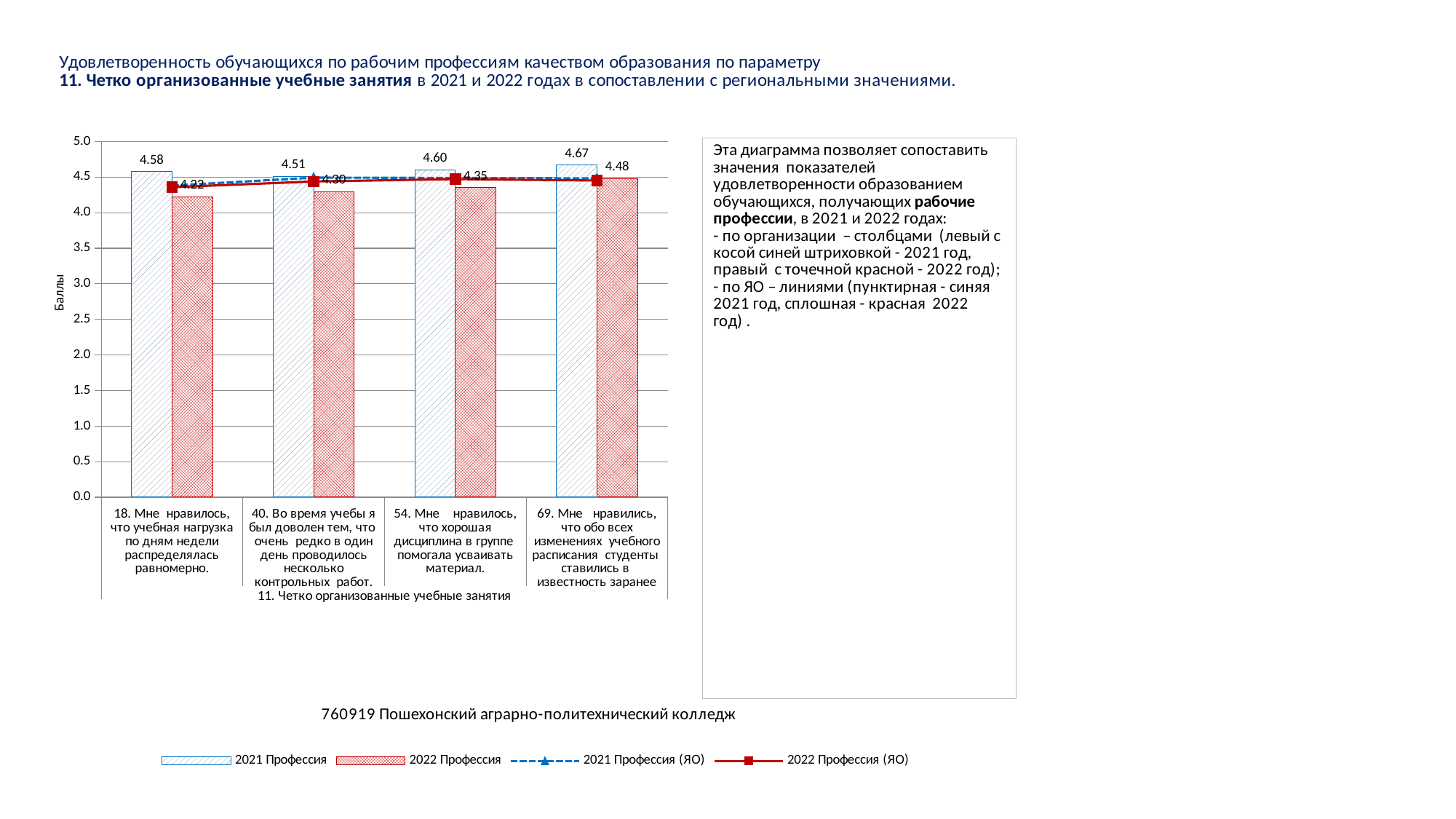
What is the value of the 2021 Профессия bar for item 69 (Мне нравились, что обо всех изменениях учебного расписания студенты ставились в известность заранее)? 4.67 Which item has the lowest 2021 Профессия bar? 40. Во время учебы я был доволен тем, что очень редко в один день проводилось несколько контрольных работ Which item has the highest 2021 Профессия bar? 69. Мне нравились, что обо всех изменениях учебного расписания студенты ставились в известность заранее What is the value of the 2022 Профессия bar for item 54 (Мне нравилось, что хорошая дисциплина в группе помогала усваивать материал)? 4.35 Which is larger: the 2021 Профессия value for item 54 or for item 18? Item 54 (4.60) Is the 2022 Профессия (ЯО) line value for item 18 greater or less than 4.0? greater What is the value of the 2021 Профессия bar for item 18 (Мне нравилось, что учебная нагрузка по дням недели распределялась равномерно)? 4.58 What is the value of the 2022 Профессия bar for item 69? 4.48 How many categories (survey items) are shown on the x axis? 4 What is the difference between the 2021 Профессия and 2022 Профессия values for item 69? 0.19 Do the 2022 Профессия bar values rise or fall from left to right along the x axis? rise How many series does the legend list? 4